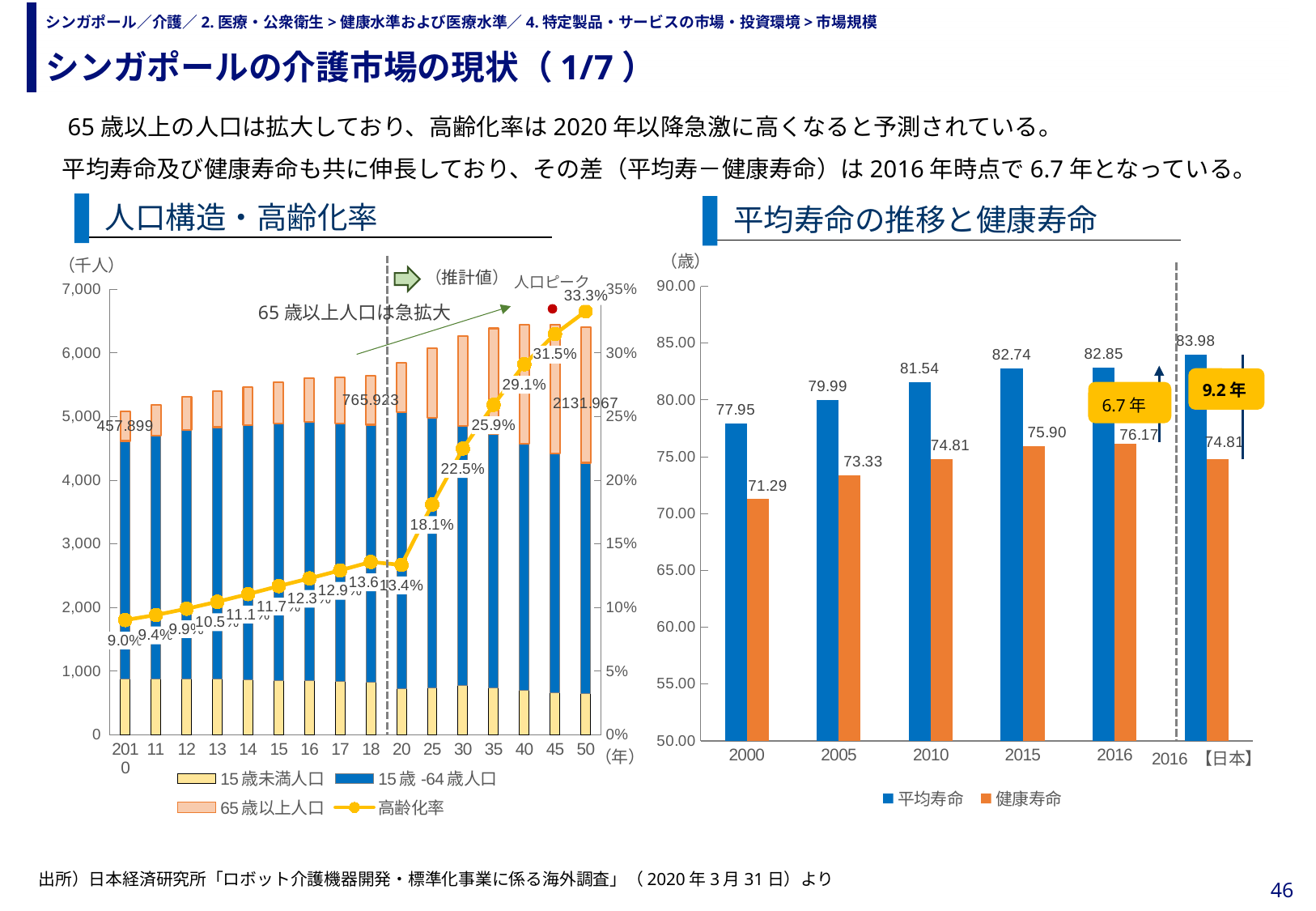
In the 平均寿命の推移と健康寿命 chart, what is the difference between the 平均寿命 for 2016【日本】 and for 2016? 1.13 In the 平均寿命の推移と健康寿命 chart, how many series does the legend list? 2 In the 平均寿命の推移と健康寿命 chart, how many categories are shown on the x axis? 6 In the 人口構造・高齢化率 chart, what is the 65歳以上人口 value labelled for 2050? 2131.967 In the 平均寿命の推移と健康寿命 chart, which category has the lowest 健康寿命? 2000 In the 人口構造・高齢化率 chart, does the 高齢化率 line rise or fall from 2010 to 2050? rise In the 人口構造・高齢化率 chart, what is the 高齢化率 value for 2050? 33.3% In the 平均寿命の推移と健康寿命 chart, what is the 平均寿命 value for 2000? 77.95 In the 人口構造・高齢化率 chart, how many series does the legend list? 4 What kind of chart is the 平均寿命の推移と健康寿命 chart? bar chart In the 平均寿命の推移と健康寿命 chart, which category has the highest 平均寿命? 2016【日本】 In the 平均寿命の推移と健康寿命 chart, what is the 健康寿命 value for 2016? 76.17